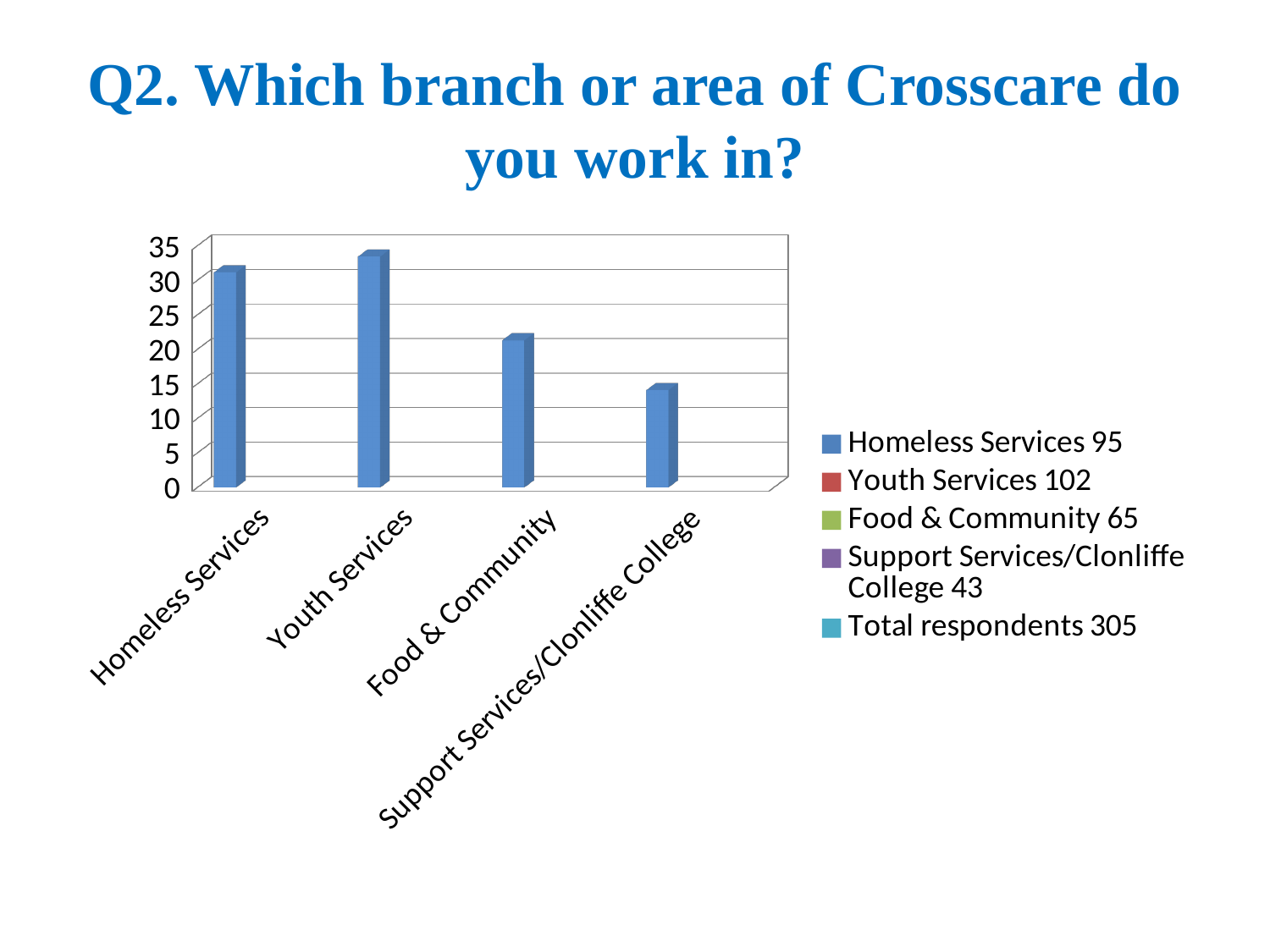
Which category has the shortest bar in the chart? Support Services/Clonliffe College How many entries does the chart's legend list? 5 Which category has the tallest bar in the chart? Youth Services Is the value for Support Services/Clonliffe College greater or less than 20? less Which bar is taller, Homeless Services or Food & Community? Homeless Services According to the legend, what number is shown next to Total respondents? 305 What is the title of the slide containing the chart? Q2. Which branch or area of Crosscare do you work in? What kind of chart is shown on the slide? bar chart Is the value for Food & Community greater or less than 25? less Is the value for Youth Services greater or less than 30? greater How many categories are plotted on the x axis of the chart? 4